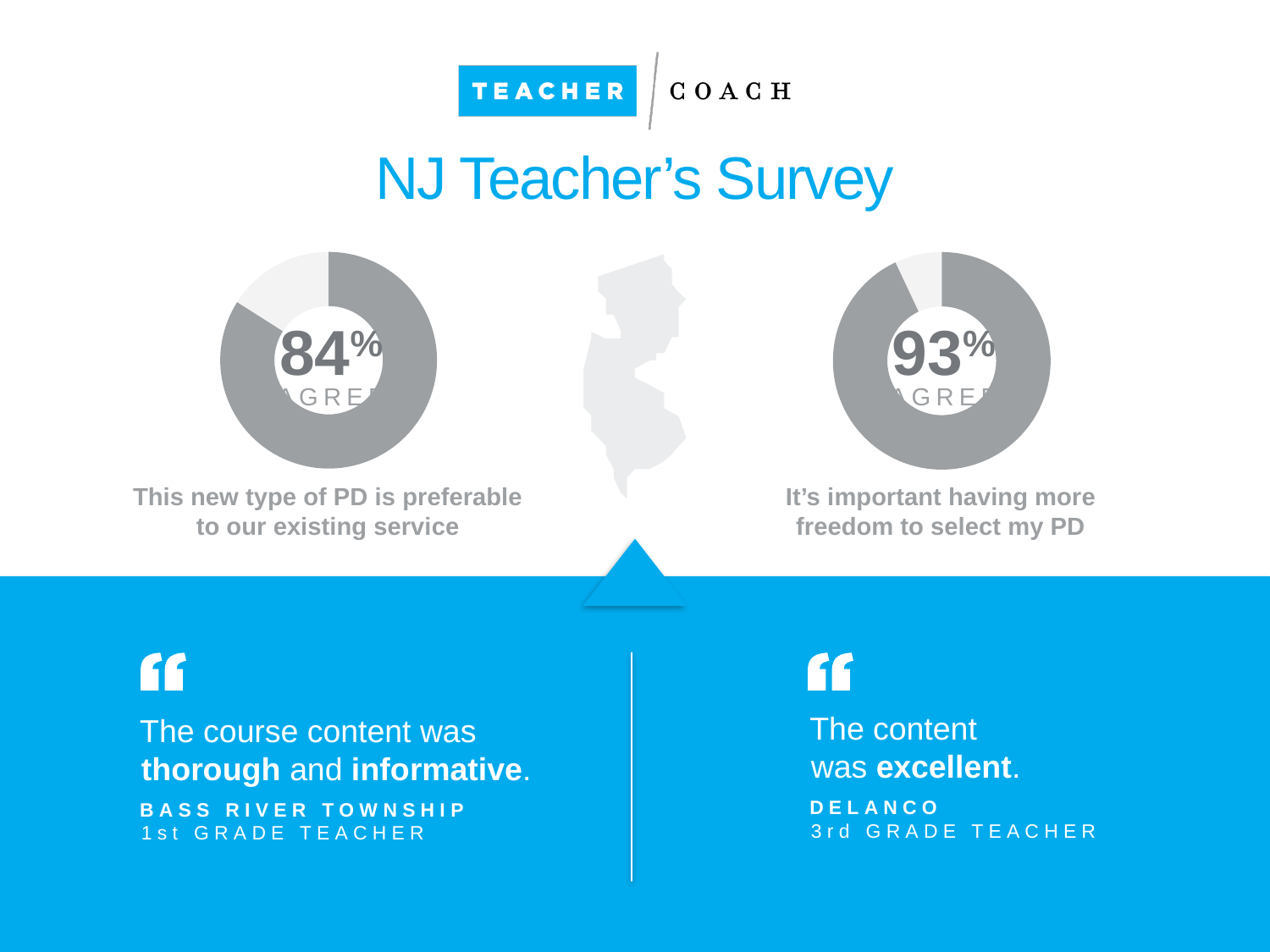
What kind of chart is used to show the 84% agreement figure on the left? donut (pie) chart What is the title of the slide containing the two donut charts? NJ Teacher's Survey On the left donut chart, what share of the ring is not part of the 84% agree segment? 16% On the left donut chart, what percentage of teachers agree that this new type of PD is preferable to their existing service? 84% What statement is the right donut chart (93%) measuring agreement with? It's important having more freedom to select my PD On the right donut chart, what share of the ring is not part of the 93% agree segment? 7% How many donut charts are shown on the slide? 2 Is the agreement value on the left donut chart greater or less than 90%? less Which of the two donut charts shows the higher agreement percentage, the left one (PD preferable to existing service) or the right one (freedom to select PD)? the right one (freedom to select PD) What is the difference in percentage points between the agreement shown on the right donut chart and the agreement shown on the left donut chart? 9 On the right donut chart, what percentage of teachers agree that it's important having more freedom to select their PD? 93% Is the agreement value on the right donut chart greater or less than 90%? greater